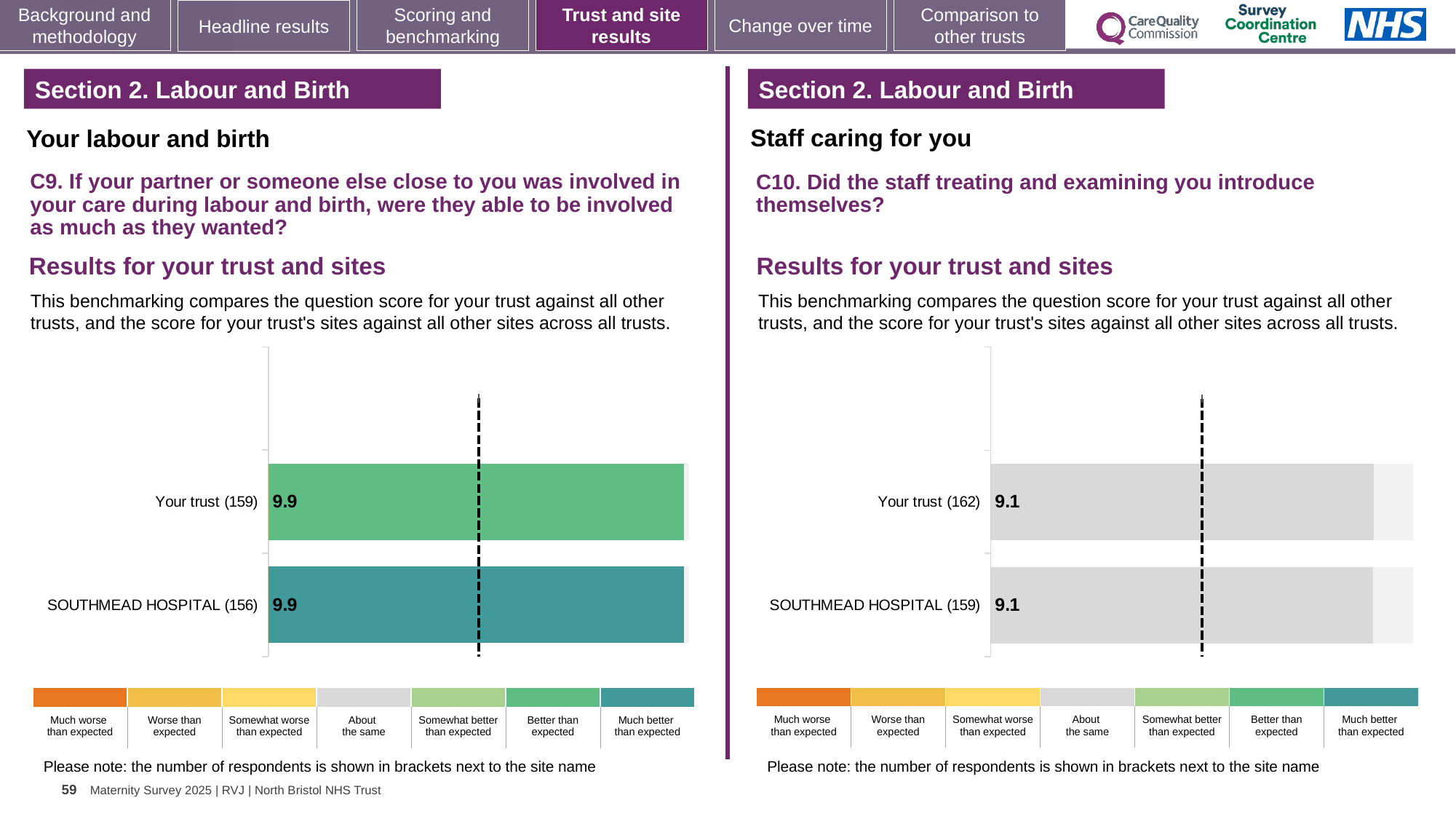
In the C10 chart on the right, which legend category does the grey colour of the Your trust (162) bar correspond to? About the same What kind of chart is used for the C9 results on the left? Bar chart In the C10 chart on the right, what is the score for SOUTHMEAD HOSPITAL (159)? 9.1 How many categories does the colour legend below the C10 chart on the right list? 7 In the C9 chart on the left, what is the score for SOUTHMEAD HOSPITAL (156)? 9.9 How many bars are plotted in the C10 chart on the right? 2 In the C10 chart on the right, what is the score for Your trust (162)? 9.1 In the C10 chart on the right, what is the difference between the score for Your trust and the score for SOUTHMEAD HOSPITAL? 0 In the C9 chart on the left, what is the score for Your trust (159)? 9.9 How many bars are plotted in the C9 chart on the left? 2 In the C9 chart on the left, what is the difference between the score for Your trust and the score for SOUTHMEAD HOSPITAL? 0 In the C9 chart on the left, which legend category does the colour of the SOUTHMEAD HOSPITAL (156) bar correspond to? Much better than expected